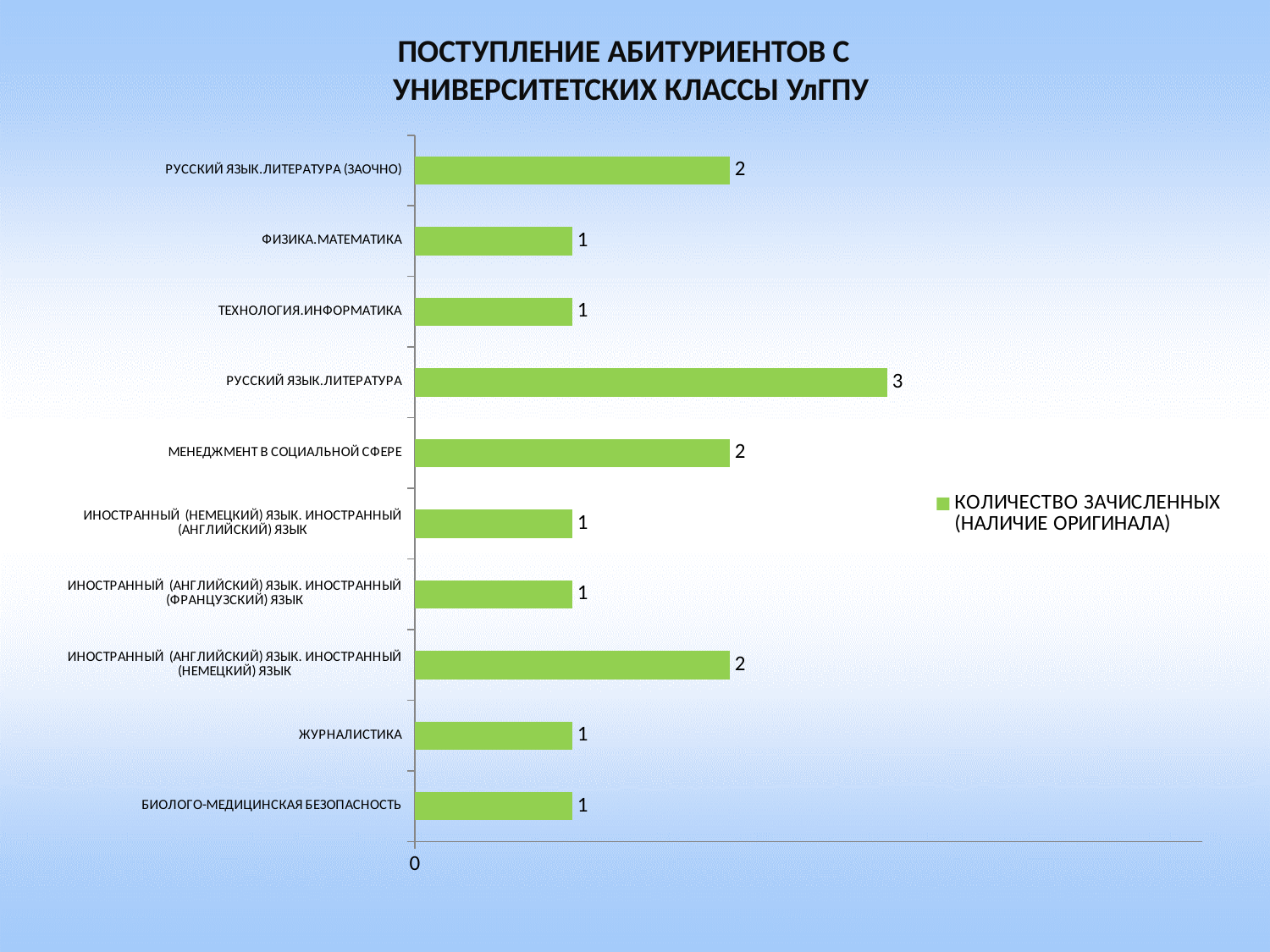
What is the legend entry for the series? КОЛИЧЕСТВО ЗАЧИСЛЕННЫХ (НАЛИЧИЕ ОРИГИНАЛА) What is the value for РУССКИЙ ЯЗЫК.ЛИТЕРАТУРА (ЗАОЧНО)? 2 How many series does the legend list? 1 Which category has the highest value? РУССКИЙ ЯЗЫК.ЛИТЕРАТУРА What is the difference between the values for РУССКИЙ ЯЗЫК.ЛИТЕРАТУРА and ФИЗИКА.МАТЕМАТИКА? 2 Which is larger, the value for МЕНЕДЖМЕНТ В СОЦИАЛЬНОЙ СФЕРЕ or the value for ТЕХНОЛОГИЯ.ИНФОРМАТИКА? МЕНЕДЖМЕНТ В СОЦИАЛЬНОЙ СФЕРЕ What kind of chart is shown on the slide? Bar chart What is the difference between the values for ИНОСТРАННЫЙ (АНГЛИЙСКИЙ) ЯЗЫК. ИНОСТРАННЫЙ (НЕМЕЦКИЙ) ЯЗЫК and БИОЛОГО-МЕДИЦИНСКАЯ БЕЗОПАСНОСТЬ? 1 What is the value for РУССКИЙ ЯЗЫК.ЛИТЕРАТУРА? 3 How many categories are shown in the chart? 10 What is the value for МЕНЕДЖМЕНТ В СОЦИАЛЬНОЙ СФЕРЕ? 2 What is the value for ЖУРНАЛИСТИКА? 1